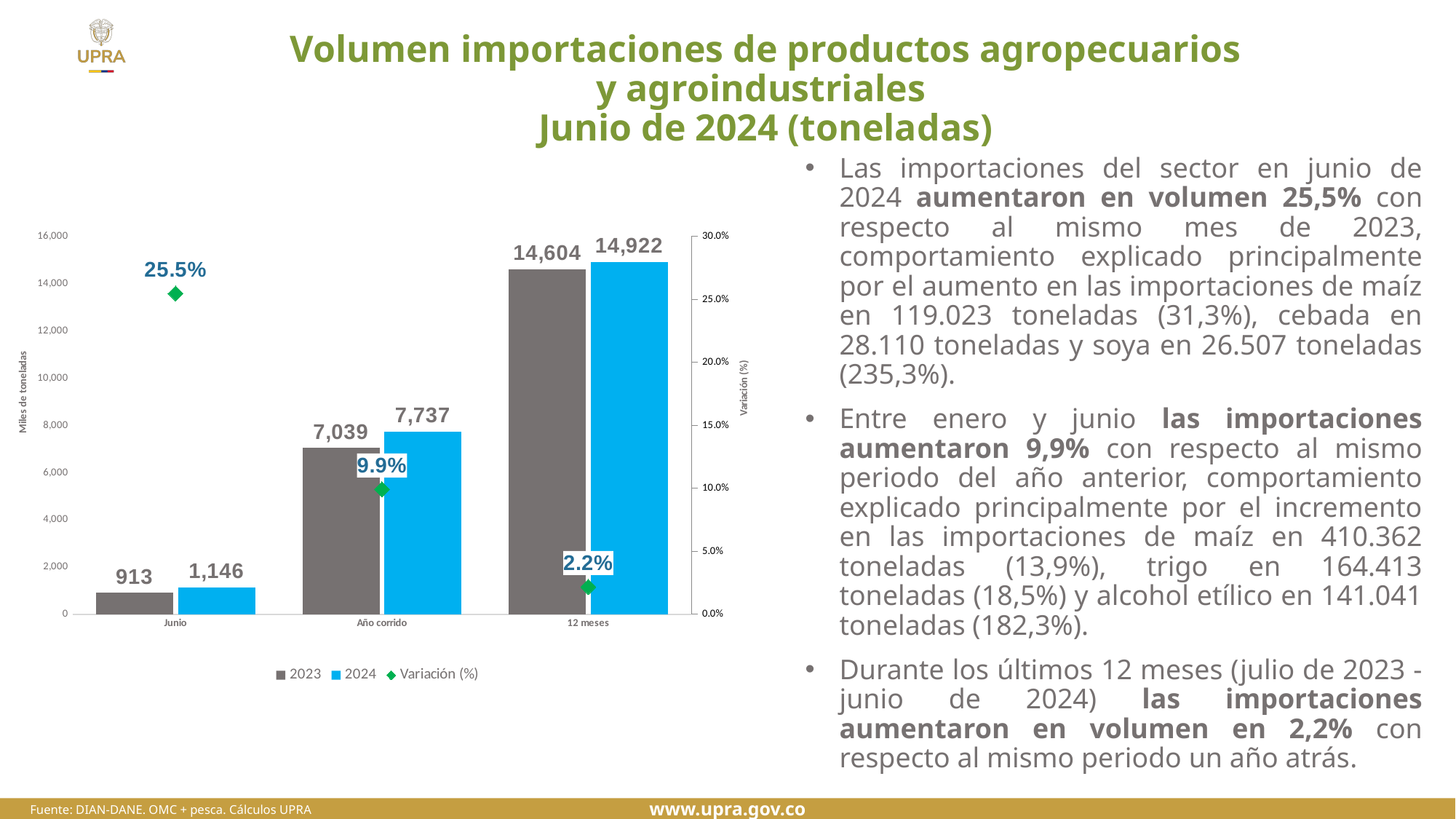
How many categories are shown on the x axis? 3 What is the difference between the 2024 and 2023 values in the Año corrido category? 698 How many series does the legend list? 3 Which category has the lowest value for the 2023 series? Junio What is the value for 2024 in the Junio category? 1,146 What is the value for 2023 in the Año corrido category? 7,039 Which is larger in the Junio category, the 2023 value or the 2024 value? 2024 What kind of chart is shown on the slide? Combination bar and line chart (bars for 2023 and 2024 with diamond markers for Variación %) What is the difference between the 2024 and 2023 values in the 12 meses category? 318 Which category has the highest value for the 2024 series? 12 meses What is the Variación (%) value shown for the 12 meses category? 2.2% What is the Variación (%) value shown for the Junio category? 25.5%